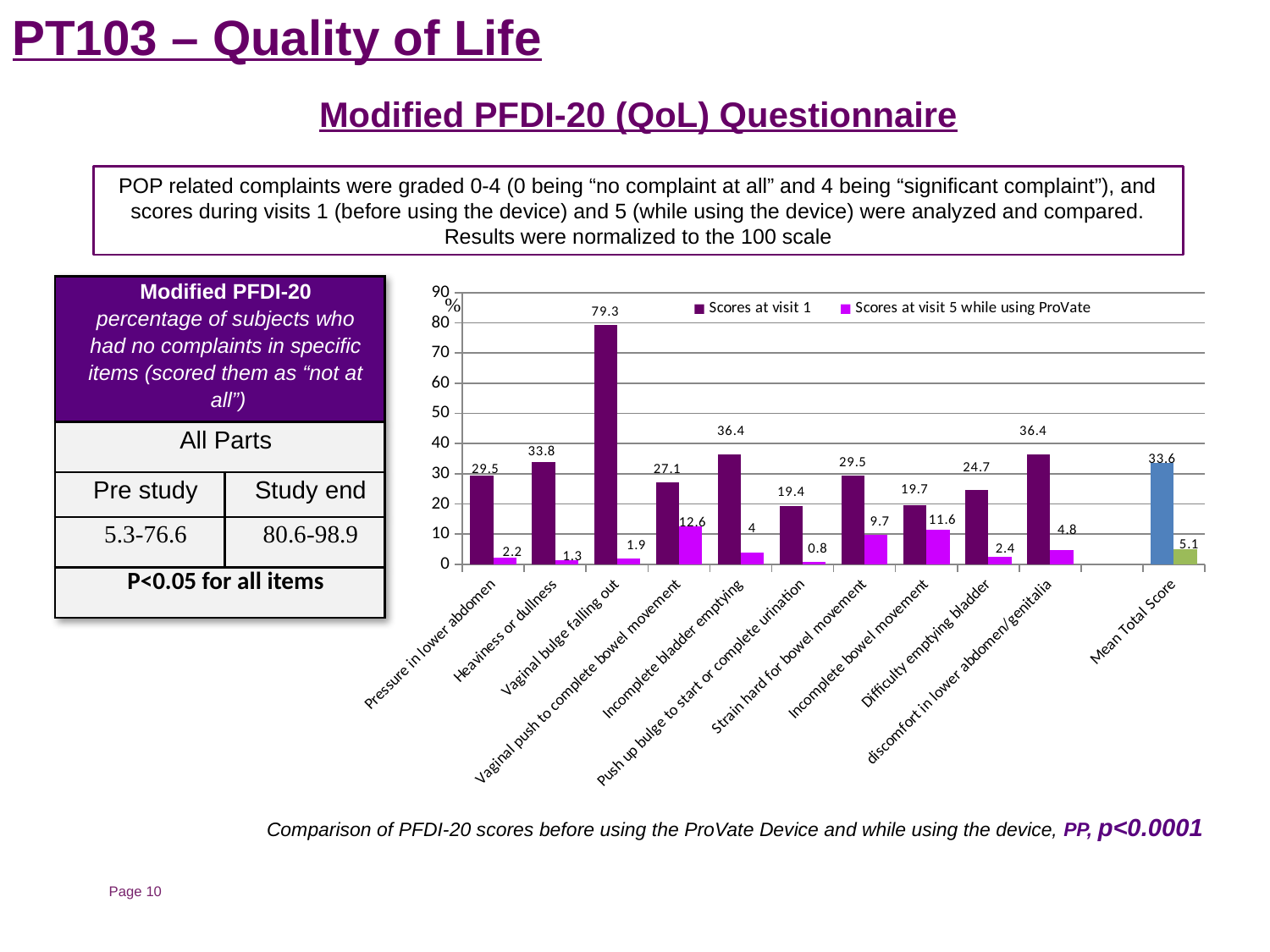
What is the score at visit 5 while using ProVate for Push up bulge to start or complete urination? 0.8 What is the second series named in the chart legend? Scores at visit 5 while using ProVate Which is larger: the visit 1 score for Heaviness or dullness or the visit 1 score for Difficulty emptying bladder? Heaviness or dullness What is the difference between the visit 1 score and the visit 5 score for Incomplete bladder emptying? 32.4 What is the Mean Total Score at visit 1? 33.6 What is the score at visit 1 for Vaginal bulge falling out? 79.3 How many series does the chart legend list? 2 What is the score at visit 5 while using ProVate for Vaginal push to complete bowel movement? 12.6 How many categories are shown on the x axis of the chart? 11 Which category has the highest score at visit 1? Vaginal bulge falling out Which category has the lowest score at visit 5 while using ProVate? Push up bulge to start or complete urination What kind of chart is shown on the slide? Bar chart